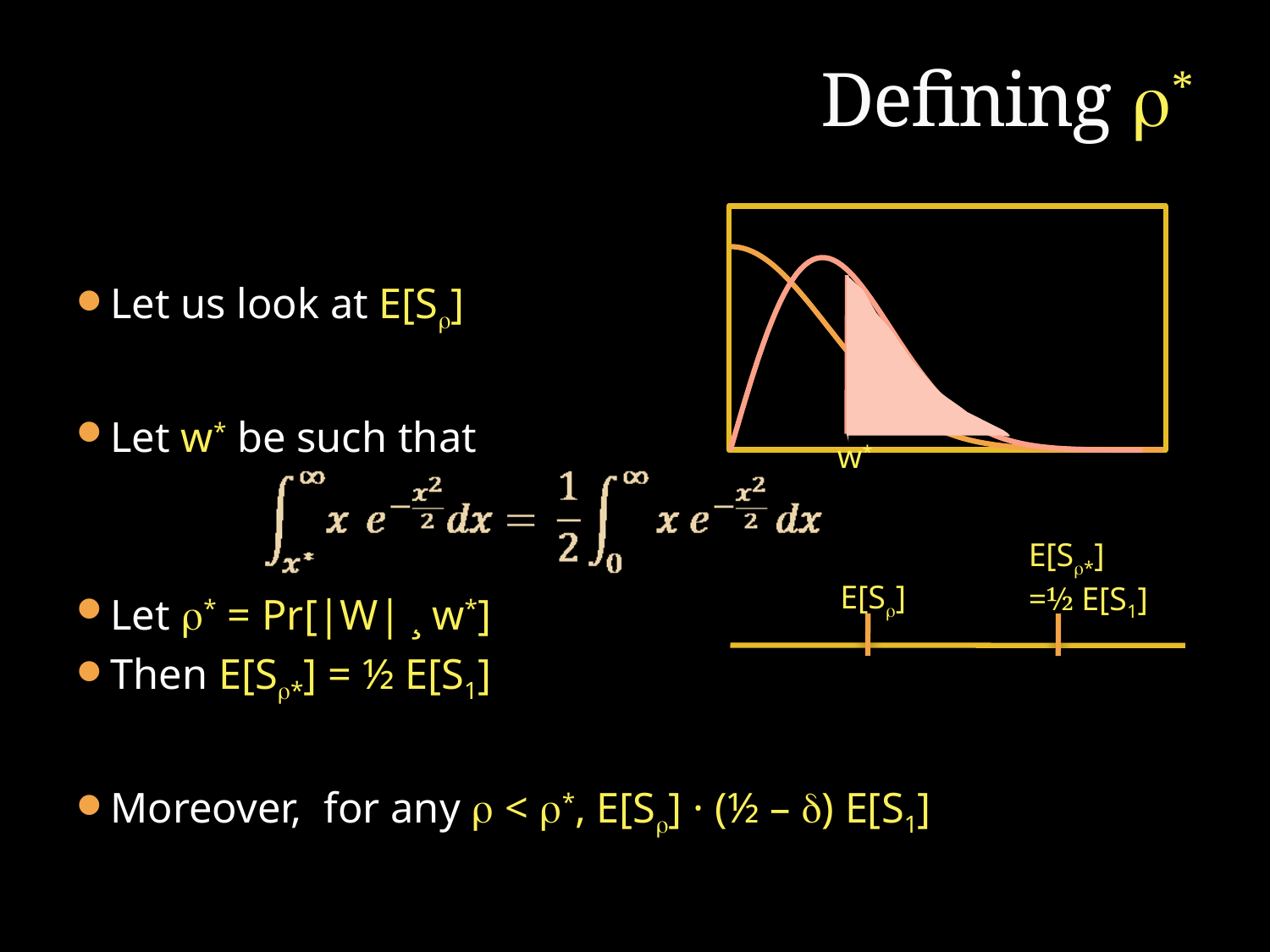
In the curve diagram at the upper right, what label marks the left boundary of the shaded region on the horizontal axis? w* On the number line diagram at the lower right, what value is E[S_ρ*] labelled as equal to? ½ E[S_1] How many curves are drawn in the curve diagram at the upper right? 2 In the curve diagram at the upper right, does the orange curve rise or fall as x increases from the left edge? fall On the number line diagram at the lower right, which of the two marked quantities is further to the right, E[S_ρ] or E[S_ρ*]? E[S_ρ*]